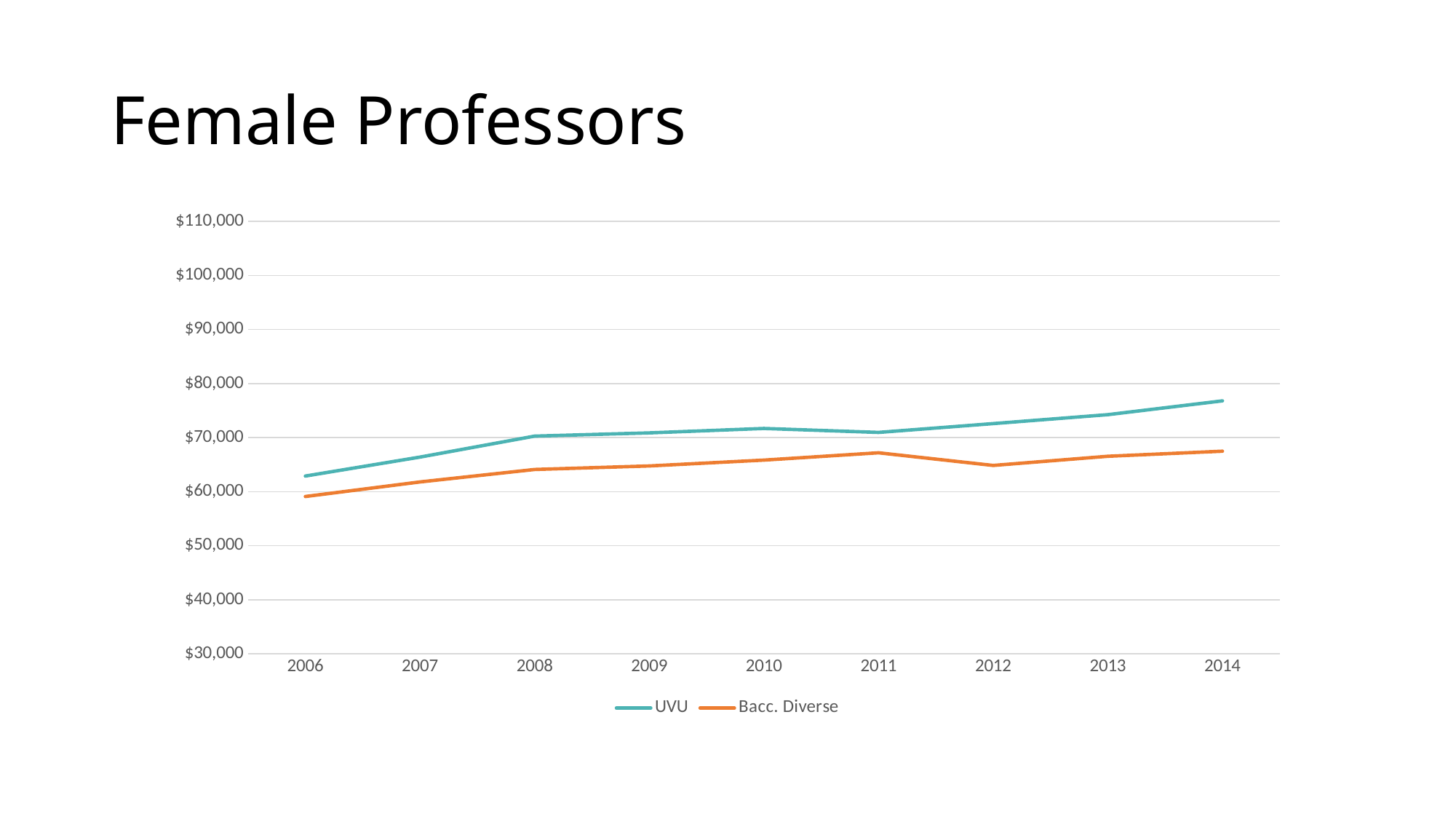
In which year is the Bacc. Diverse series at its lowest? 2006 Is the UVU value for 2014 greater or less than $80,000? less Is the Bacc. Diverse value for 2012 greater or less than $70,000? less What kind of chart is shown on the slide? line chart Is the Bacc. Diverse value for 2006 greater or less than $60,000? less What is the title of the slide? Female Professors Does the UVU series generally rise or fall from 2006 to 2014? rise How many series does the legend list? 2 Which series has the higher value in 2014, UVU or Bacc. Diverse? UVU How many years are shown on the x axis? 9 In which year is the UVU series at its highest? 2014